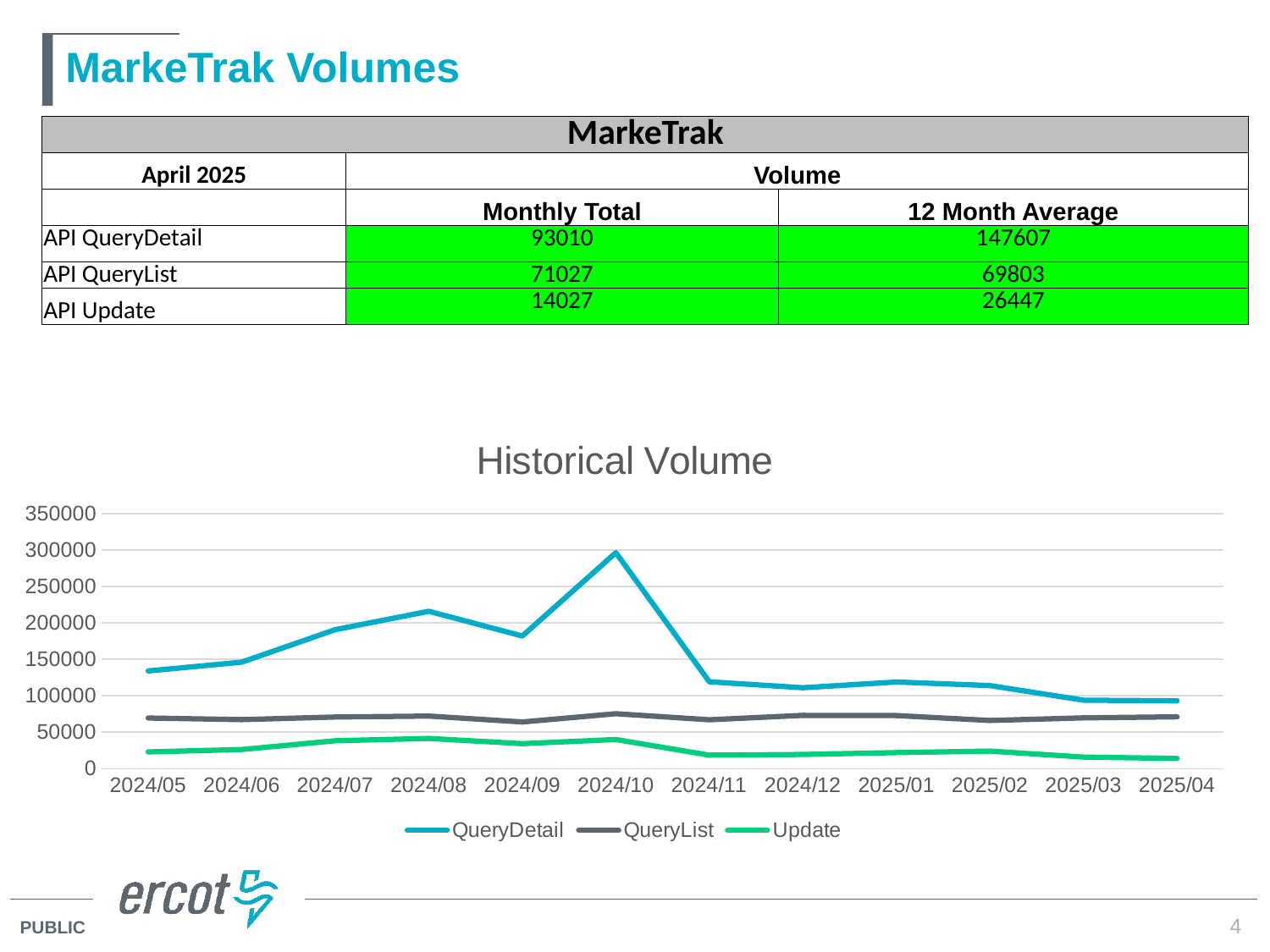
What kind of chart is the Historical Volume chart? line chart In the Historical Volume chart, is the Update value for 2024/10 greater or less than 50000? less What is the title of the line chart on the slide? Historical Volume How many months are plotted along the x axis of the Historical Volume chart? 12 In the Historical Volume chart, which series is higher at 2024/05, Update or QueryList? QueryList In the Historical Volume chart, is the QueryDetail value for 2024/10 greater or less than 250000? greater How many series does the legend of the Historical Volume chart list? 3 In the Historical Volume chart, is the QueryDetail value for 2024/05 greater or less than 100000? greater In the Historical Volume chart, which month has the highest QueryDetail value? 2024/10 In the Historical Volume chart, which series is higher at 2024/10, QueryDetail or QueryList? QueryDetail In the Historical Volume chart, does the QueryDetail series rise or fall from 2024/10 to 2024/11? fall